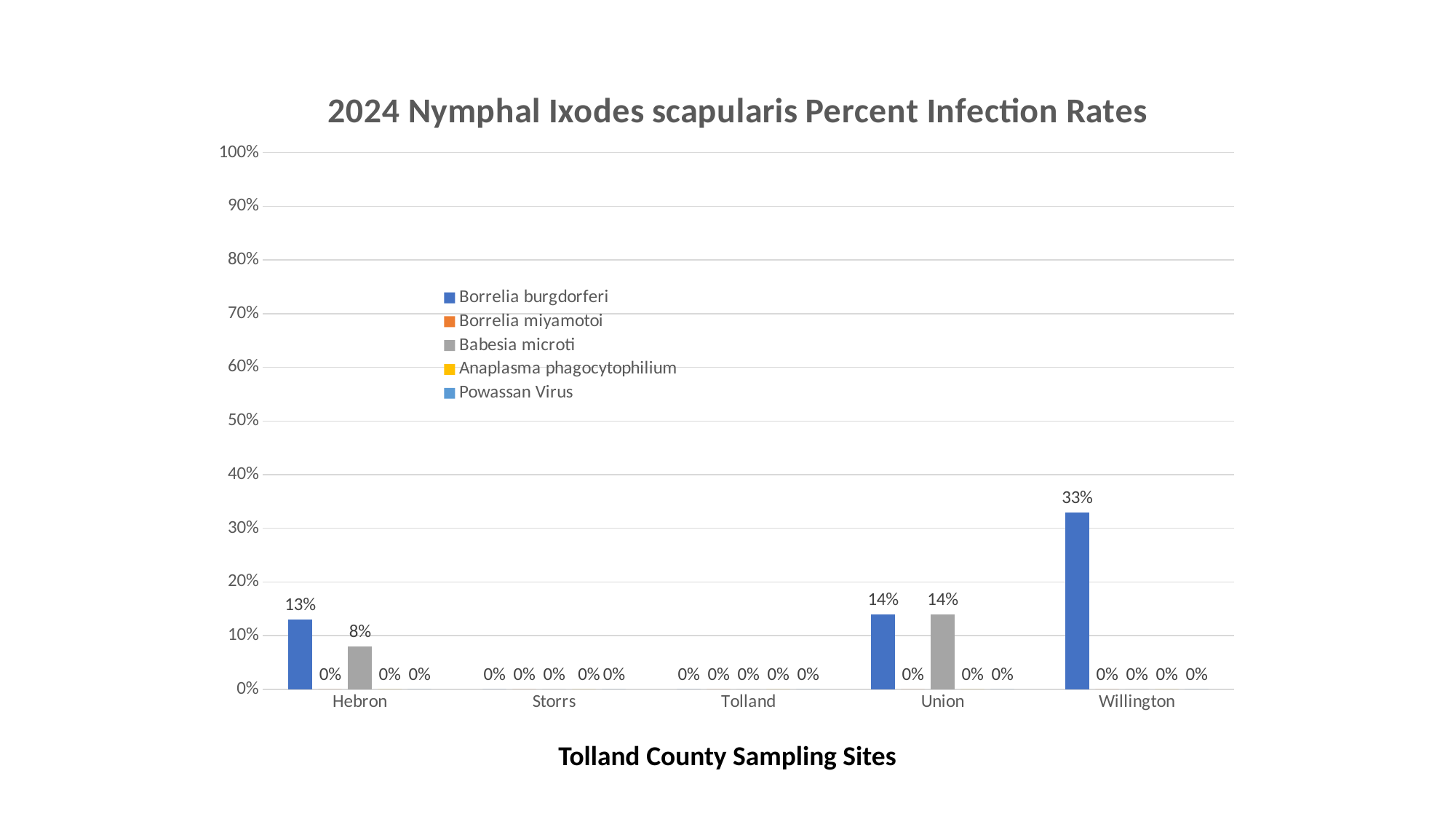
How many series does the legend list? 5 What is the Borrelia burgdorferi infection rate at Willington? 33% What is the x-axis title of the chart? Tolland County Sampling Sites What is the Borrelia burgdorferi infection rate at Union? 14% What is the Babesia microti infection rate at Union? 14% Which sampling site has the highest Borrelia burgdorferi infection rate? Willington What is the difference between the Borrelia burgdorferi rate at Willington and at Union? 19% What is the Borrelia burgdorferi infection rate at Hebron? 13% What is the Babesia microti infection rate at Hebron? 8% How many sampling sites are shown on the x axis? 5 Which is larger at Hebron: the Borrelia burgdorferi rate or the Babesia microti rate? Borrelia burgdorferi What kind of chart is shown on the slide? Bar chart